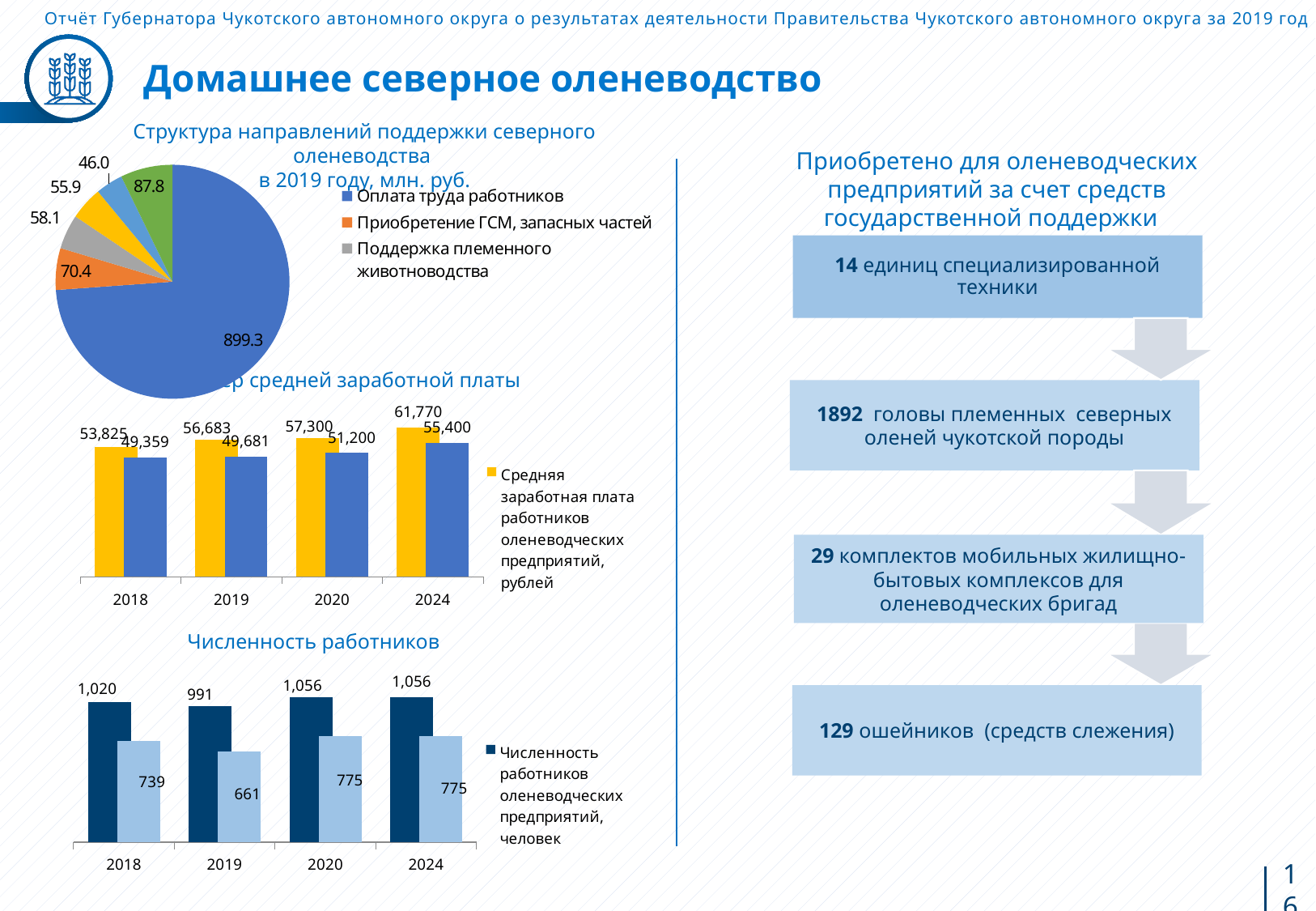
In the middle bar chart on average salary, what is the value of the yellow series 'Средняя заработная плата работников оленеводческих предприятий, рублей' for 2024? 61,770 In the chart 'Численность работников', which year has the lowest value for the light blue bar? 2019 How many years are shown on the x axis of the chart 'Численность работников'? 4 In the pie chart 'Структура направлений поддержки северного оленеводства в 2019 году, млн. руб.', which category has the largest slice? Оплата труда работников In the chart 'Численность работников', what is the value of the dark blue bar for 2019? 991 In the middle bar chart on average salary, what is the difference between the yellow and blue bars for 2020? 6,100 In the middle bar chart on average salary, what is the value of the blue bar for 2019? 49,681 In the pie chart 'Структура направлений поддержки северного оленеводства в 2019 году, млн. руб.', what is the difference between 'Приобретение ГСМ, запасных частей' and 'Поддержка племенного животноводства'? 12.3 In the pie chart 'Структура направлений поддержки северного оленеводства в 2019 году, млн. руб.', what is the value for 'Приобретение ГСМ, запасных частей'? 70.4 What type of chart is 'Структура направлений поддержки северного оленеводства в 2019 году, млн. руб.'? pie chart In the pie chart 'Структура направлений поддержки северного оленеводства в 2019 году, млн. руб.', what is the value for 'Оплата труда работников'? 899.3 In the middle bar chart on average salary, does the yellow series rise or fall from 2018 to 2024? rise